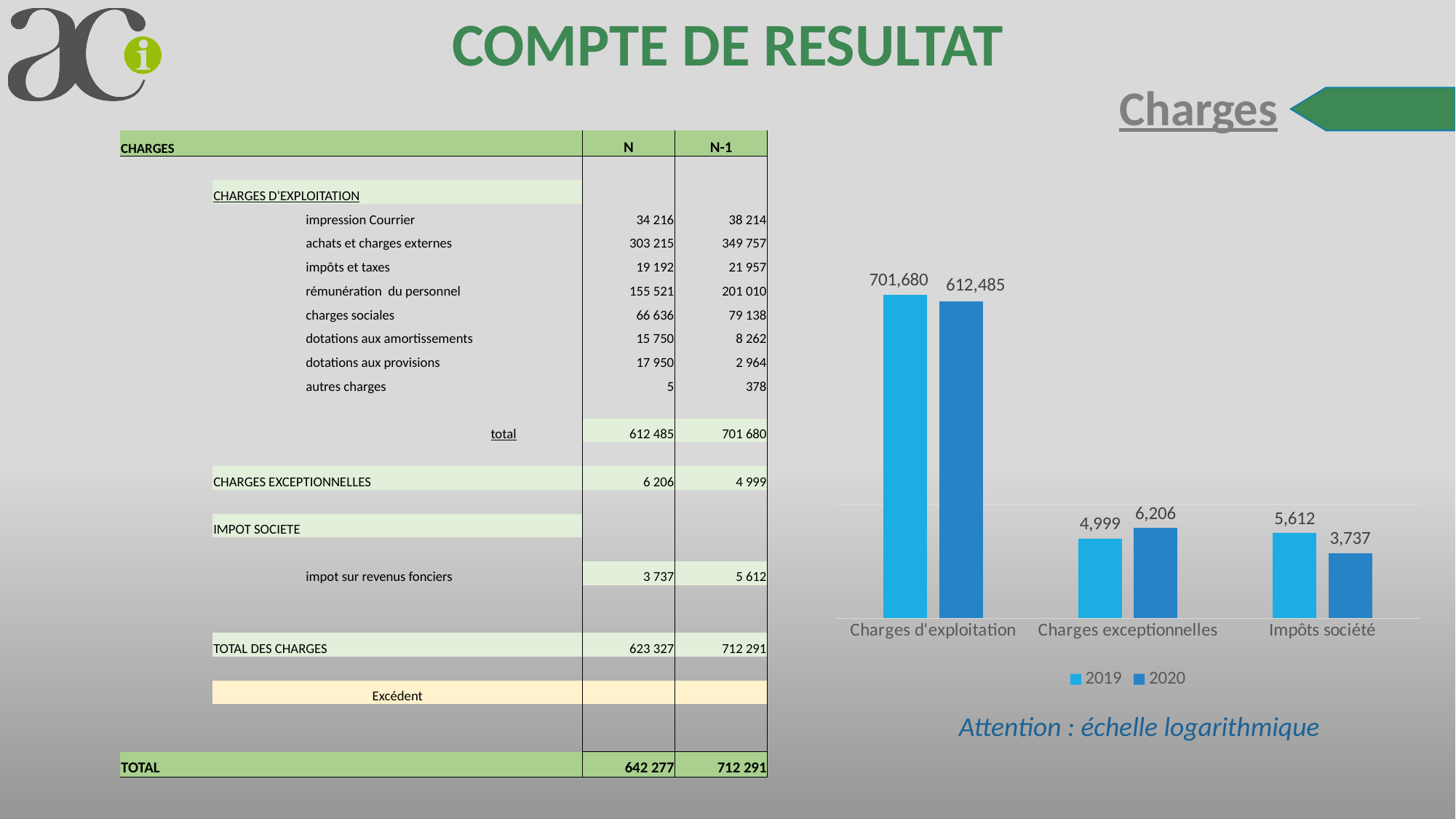
For Charges exceptionnelles, which year has the larger value, 2019 or 2020? 2020 What is the difference between the 2019 and 2020 values for Charges d'exploitation? 89,195 What is the 2020 value for Charges d'exploitation in the chart? 612,485 Which category has the highest 2020 value in the chart? Charges d'exploitation How many series does the chart legend list? 2 What is the difference between the 2019 and 2020 values for Impôts société? 1,875 What is the 2020 value for Impôts société in the chart? 3,737 Which category has the lowest 2020 value in the chart? Impôts société How many categories are shown on the x axis of the chart? 3 What is the 2019 value for Charges d'exploitation in the chart? 701,680 What kind of chart is shown on the slide? Bar chart What is the 2019 value for Charges exceptionnelles in the chart? 4,999